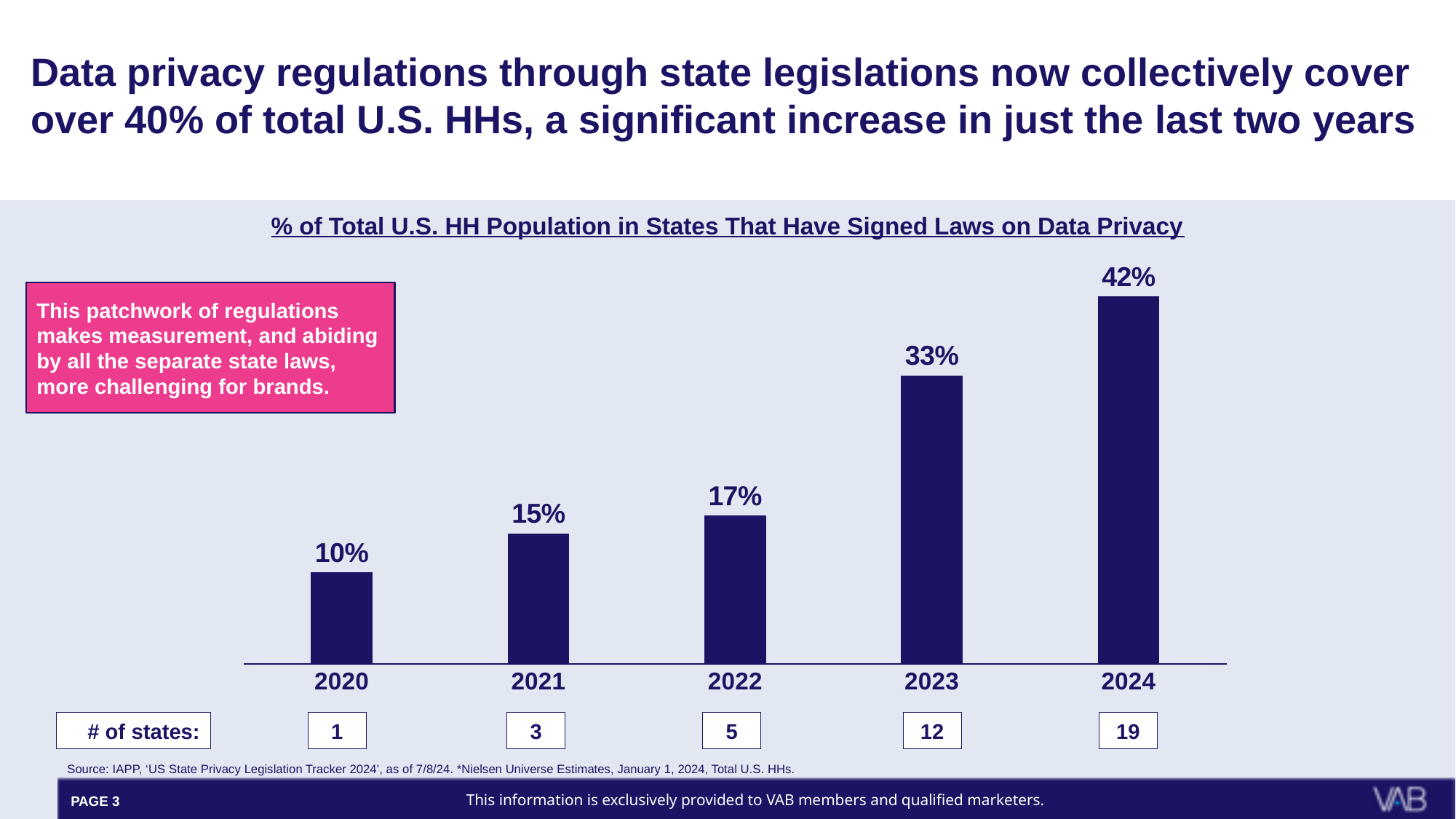
Which year has the lowest value? 2020 How many years are shown on the x axis? 5 What is the difference between the values for 2024 and 2023? 9% What is the value for 2022? 17% What is the value for 2020? 10% Do the values rise or fall from 2020 to 2024? Rise What is the title of the chart? % of Total U.S. HH Population in States That Have Signed Laws on Data Privacy What is the difference between the values for 2021 and 2020? 5% What kind of chart is this? Bar chart Which year has the highest value? 2024 Which is larger, the value for 2022 or the value for 2021? 2022 What is the value for 2023? 33%